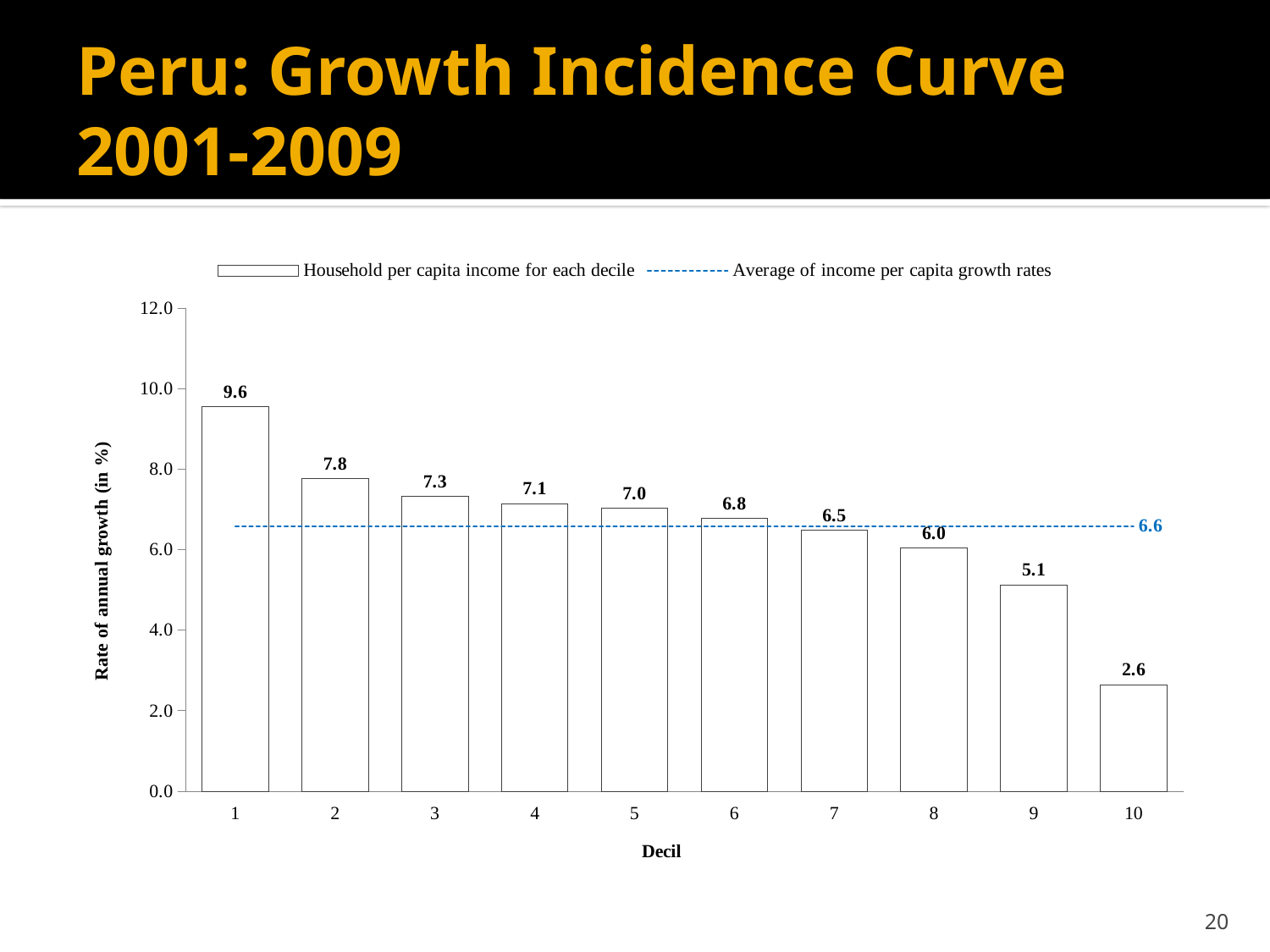
Do the growth rates rise or fall as the decile number increases? Fall How many deciles are shown on the x axis? 10 What is the rate of annual growth for decile 10? 2.6 How many entries does the legend list? 2 What is the difference between the growth rates of decile 1 and decile 10? 7.0 What is the rate of annual growth for decile 5? 7.0 What kind of chart is shown on the slide? Combination bar and line chart Which has a higher growth rate, decile 3 or decile 8? Decile 3 Which decile has the lowest rate of annual growth? 10 What value does the dashed average line show? 6.6 Which decile has the highest rate of annual growth? 1 What is the rate of annual growth for decile 1? 9.6